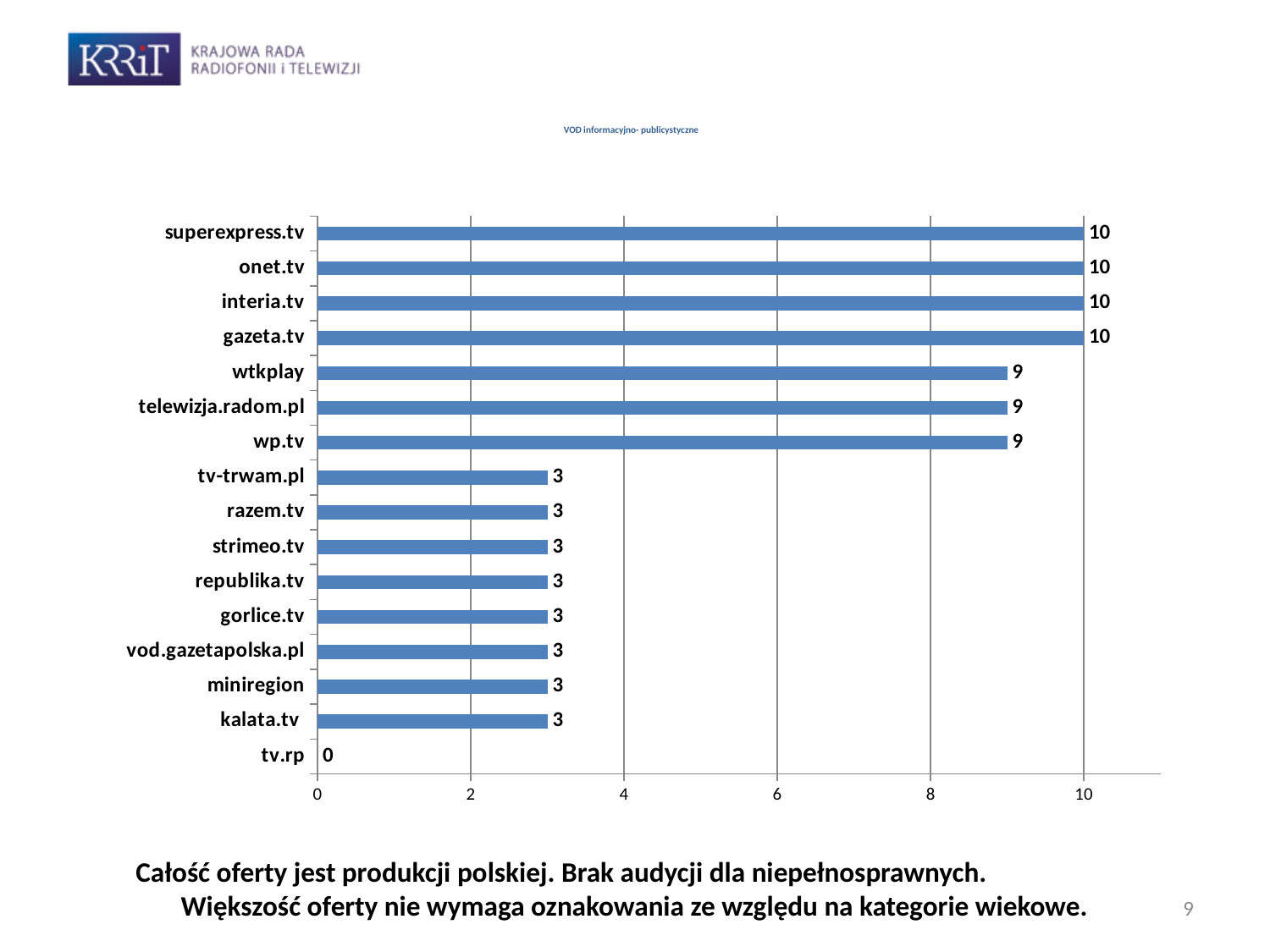
What is the value for tv.rp? 0 What is the value for tv-trwam.pl? 3 What is the title of the chart? VOD informacyjno- publicystyczne What is the difference between the values for onet.tv and wp.tv? 1 What kind of chart is shown on the slide? bar chart What is the difference between the values for telewizja.radom.pl and kalata.tv? 6 What is the value for wtkplay? 9 Is the value for wp.tv greater or less than 8? greater Which is larger, the value for interia.tv or the value for razem.tv? interia.tv How many categories are shown in the chart? 16 Which category has the lowest value? tv.rp What is the value for gazeta.tv? 10